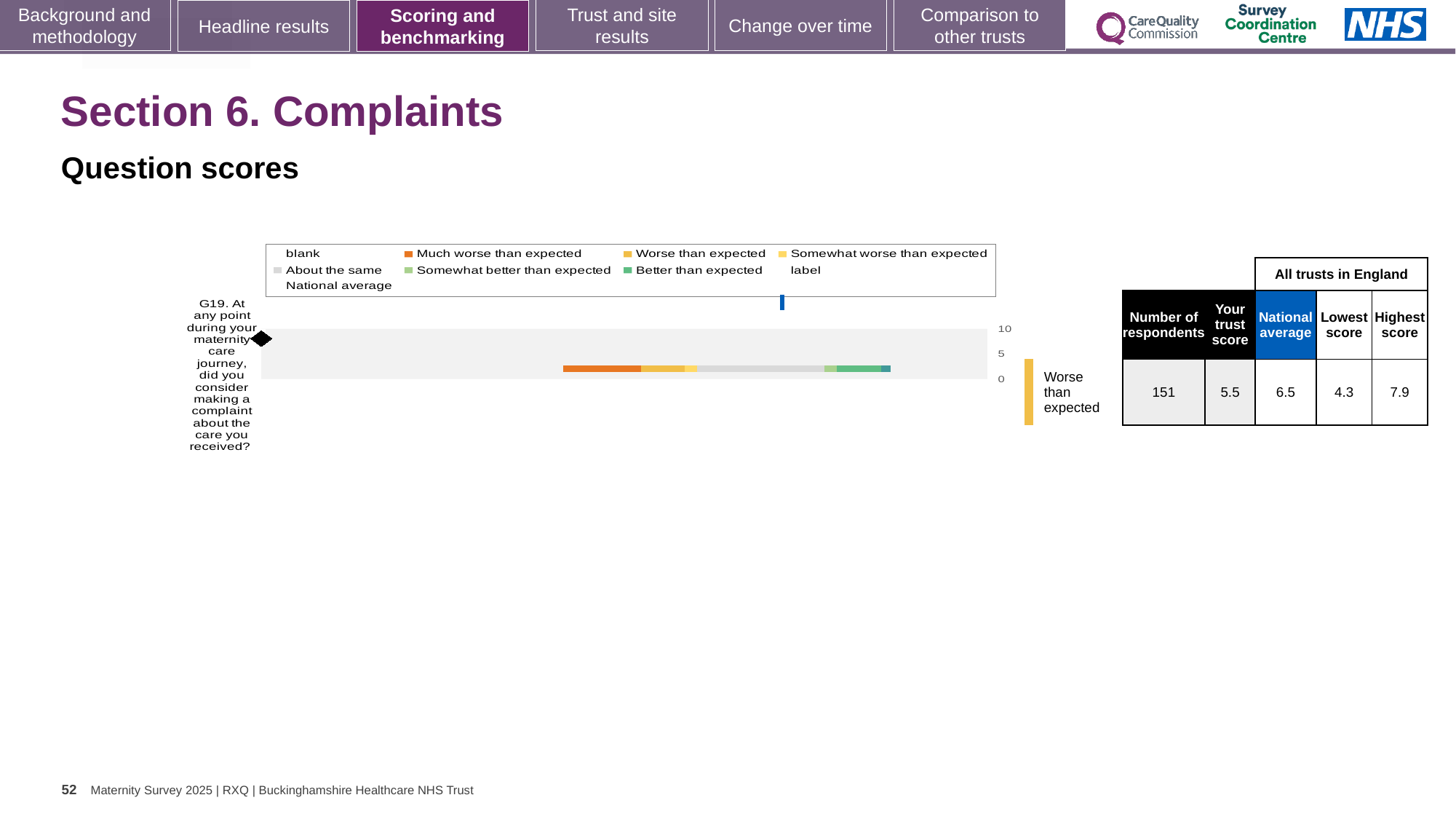
What is the national average score for question G19? 6.5 What kind of chart is shown on the slide? bar chart How many questions (categories) are plotted on the chart? 1 Which benchmarking category is the trust's result for G19 placed in, according to the label beside the chart? Worse than expected How many respondents answered question G19? 151 Which legend entry is shown in orange? Much worse than expected What is the difference between the highest score and the lowest score for question G19? 3.6 Which is larger for question G19: the trust's score or the national average? national average What is the trust's score for question G19 shown in the table next to the chart? 5.5 What is the difference between the national average and the trust's score for question G19? 1.0 What is the lowest score among all trusts in England for question G19? 4.3 What is the highest score among all trusts in England for question G19? 7.9